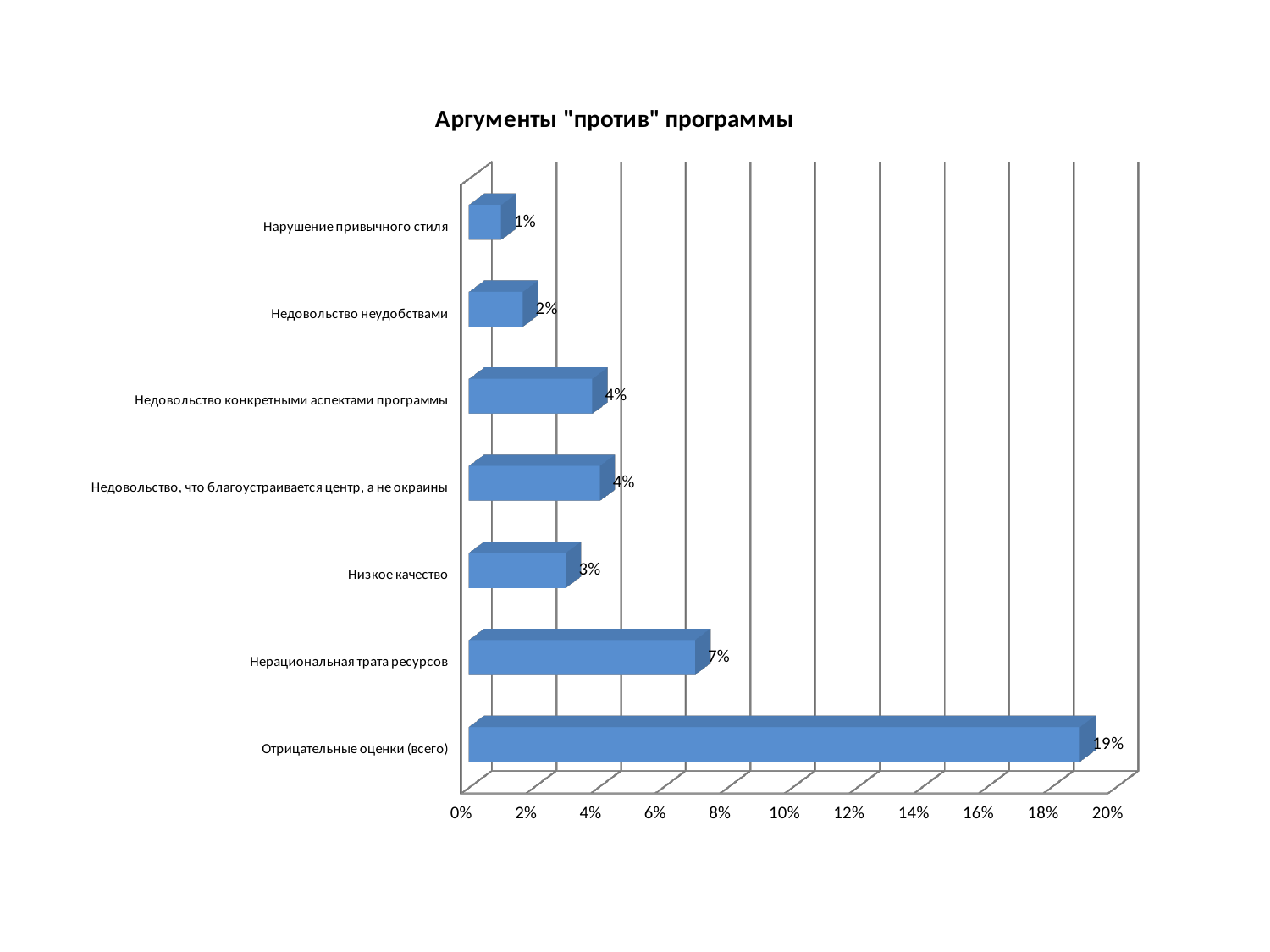
What is the value for "Нарушение привычного стиля"? 1% What is the title of the chart? Аргументы "против" программы How many categories are shown in the chart? 7 Which category has the highest value? Отрицательные оценки (всего) What is the value for "Отрицательные оценки (всего)"? 19% Is the value for "Нерациональная трата ресурсов" greater or less than 6%? greater What is the value for "Низкое качество"? 3% What is the value for "Нерациональная трата ресурсов"? 7% Which category has the lowest value? Нарушение привычного стиля What kind of chart is shown on the slide? bar chart Which is larger: "Нерациональная трата ресурсов" or "Низкое качество"? Нерациональная трата ресурсов What is the difference between "Отрицательные оценки (всего)" and "Нерациональная трата ресурсов"? 12%